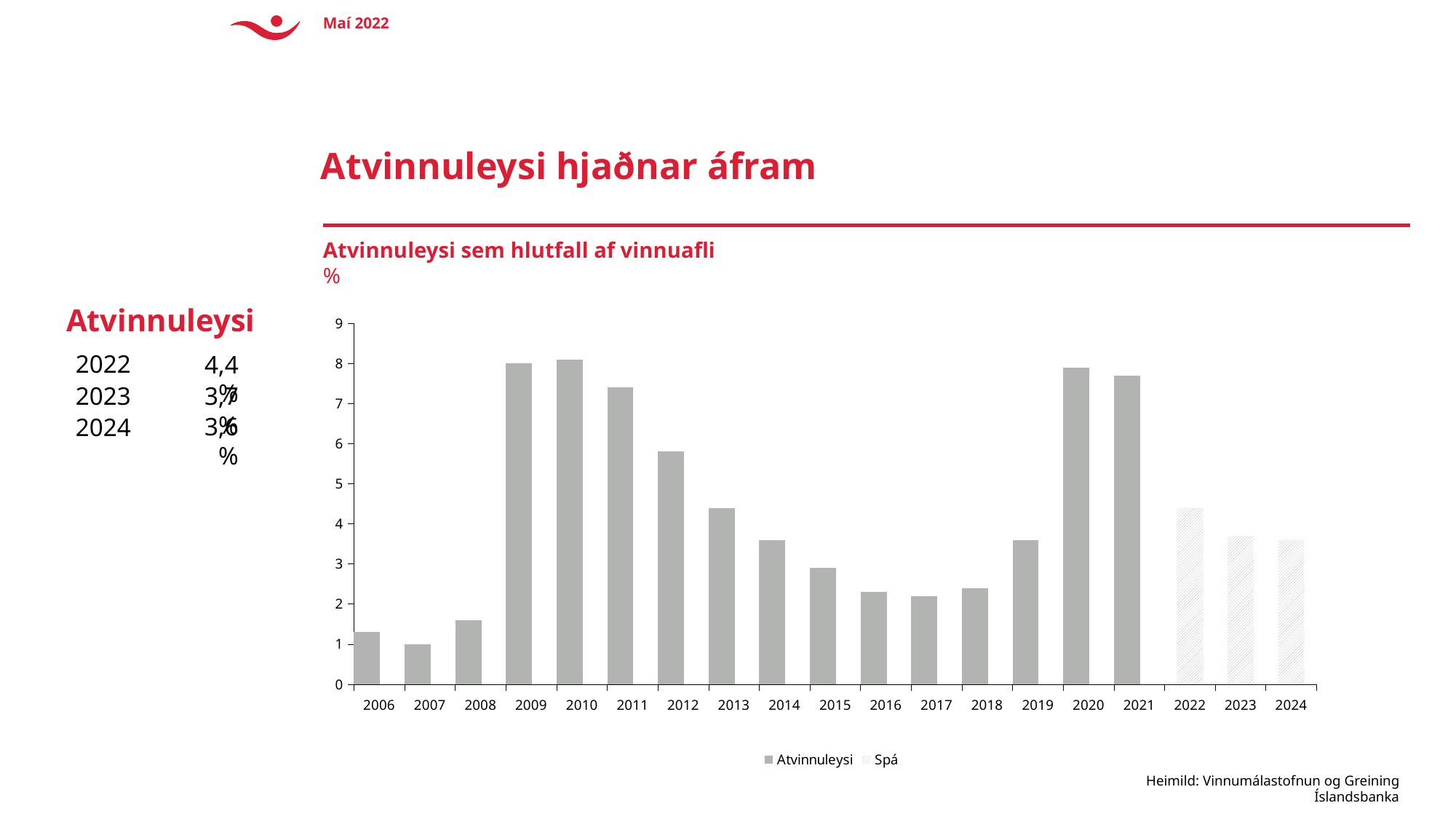
Which year has the higher unemployment rate, 2009 or 2013? 2009 What is the unemployment rate shown for 2024? 3,6% What is the unemployment rate shown for 2023? 3,7% What kind of chart is shown on the slide? bar chart How many years are shown on the x axis of the chart? 19 How many series does the chart legend list? 2 Do the values rise or fall from 2010 to 2017? fall Is the value for 2012 greater or less than 5? greater What is the difference between the values for 2022 and 2024? 0,8 Which year has the lowest unemployment rate in the chart? 2007 What is the unemployment rate shown for 2022? 4,4% Is the value for 2016 greater or less than 3? less